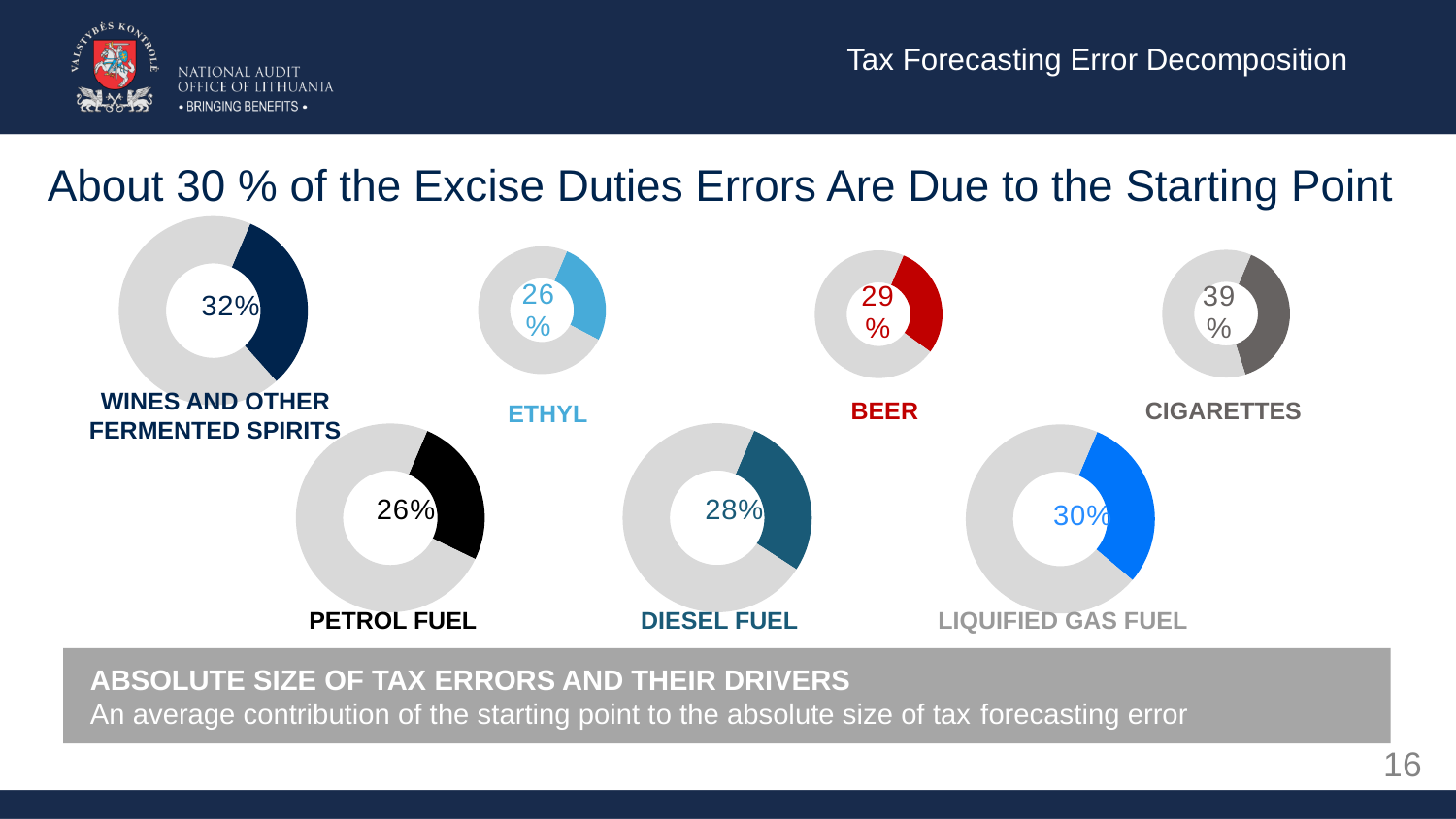
Which shows a larger percentage, the DIESEL FUEL chart or the LIQUIFIED GAS FUEL chart? LIQUIFIED GAS FUEL In the donut chart labelled ETHYL, what percentage is shown? 26% In the donut chart labelled BEER, what percentage is shown? 29% How many donut charts are shown on the slide? 7 What kind of chart is used for each category on the slide? Donut (pie) chart In the donut chart labelled DIESEL FUEL, what percentage is shown? 28% What is the difference between the percentage shown in the CIGARETTES chart and the percentage shown in the ETHYL chart? 13% Across all the donut charts on the slide, which category shows the highest percentage? CIGARETTES In the donut chart labelled WINES AND OTHER FERMENTED SPIRITS, what percentage is shown? 32% In the donut chart labelled LIQUIFIED GAS FUEL, what percentage is shown? 30% In the donut chart labelled CIGARETTES, what percentage is shown? 39% In the donut chart labelled PETROL FUEL, what percentage is shown? 26%